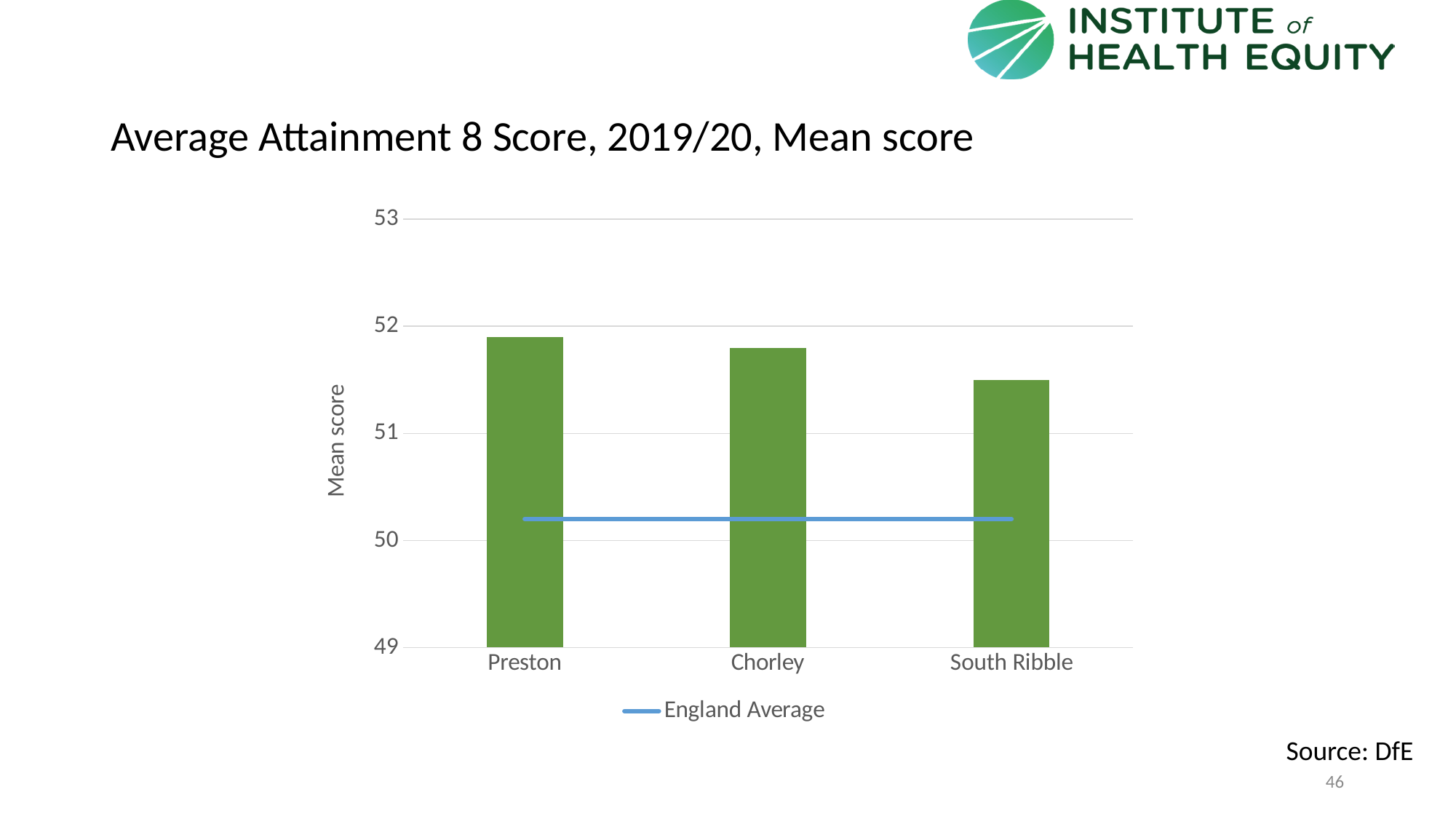
What series does the legend entry with the blue line represent? England Average Do the bar values rise or fall moving from Preston to South Ribble along the x axis? fall How many areas (categories) are plotted on the x axis? 3 How many series does the legend list? 1 What kind of chart is shown on the slide? bar chart Is the value for South Ribble greater or less than 51? greater Which is larger, the mean score for Chorley or for South Ribble? Chorley Which area has the lowest mean Attainment 8 score? South Ribble Is the England Average line greater or less than 51? less Is the value for Preston greater or less than 52? less What is the title of the chart? Average Attainment 8 Score, 2019/20, Mean score Which is larger, the mean score for Preston or for South Ribble? Preston